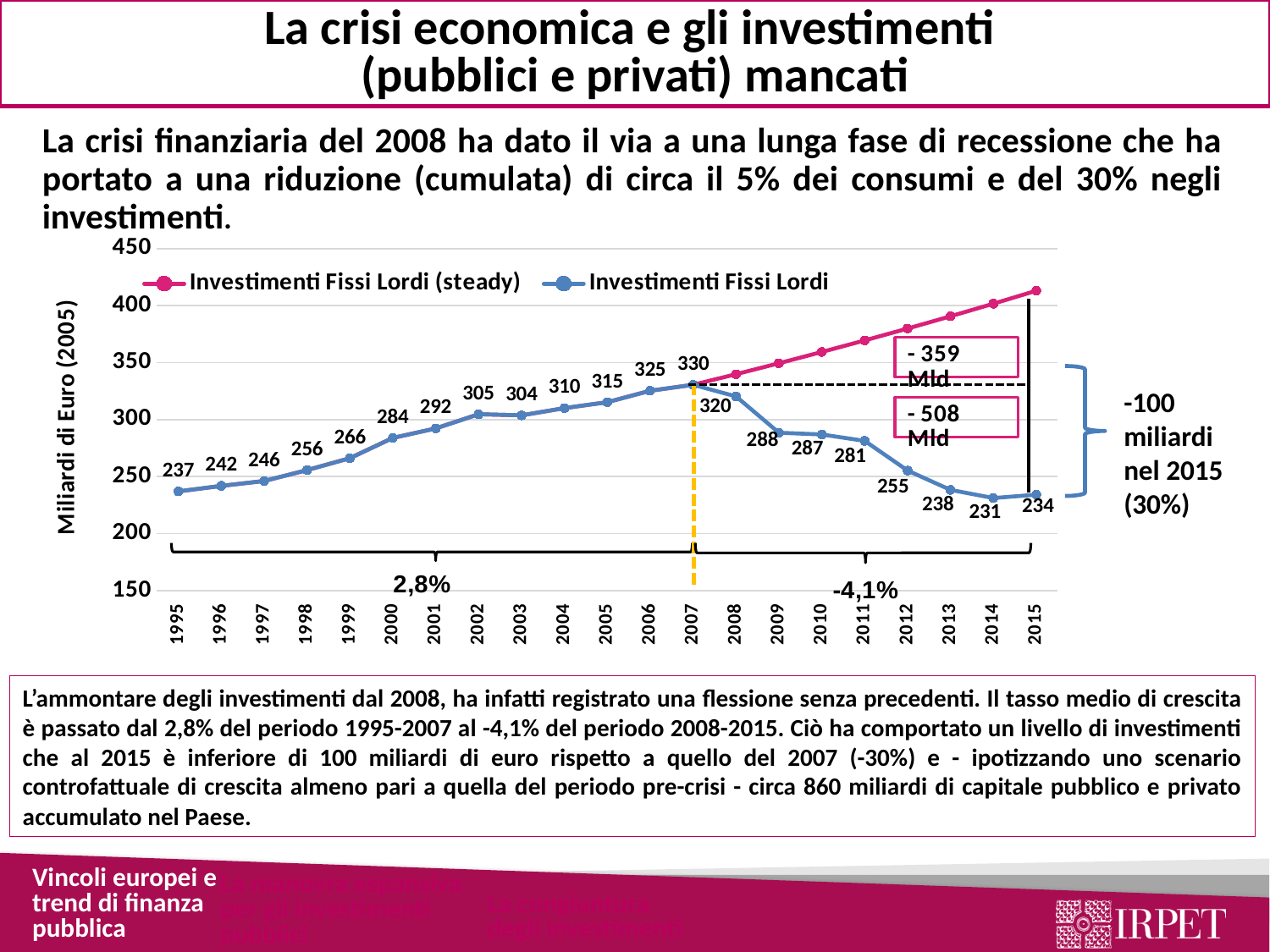
What is the difference between the Investimenti Fissi Lordi values for 2007 and 2015? 96 What is the value of Investimenti Fissi Lordi in 2007? 330 How many series does the chart legend list? 2 In which year does the Investimenti Fissi Lordi series reach its lowest value? 2014 What kind of chart is shown on the slide? line chart Is the value of Investimenti Fissi Lordi (steady) in 2015 greater or less than 400? greater What is the value of Investimenti Fissi Lordi in 2015? 234 How many years are shown on the x axis of the chart? 21 What is the value of Investimenti Fissi Lordi in 1995? 237 In which year does the Investimenti Fissi Lordi series reach its highest value? 2007 Does the Investimenti Fissi Lordi series rise or fall from 2008 to 2015? fall Which year has the larger Investimenti Fissi Lordi value, 2000 or 2010? 2010